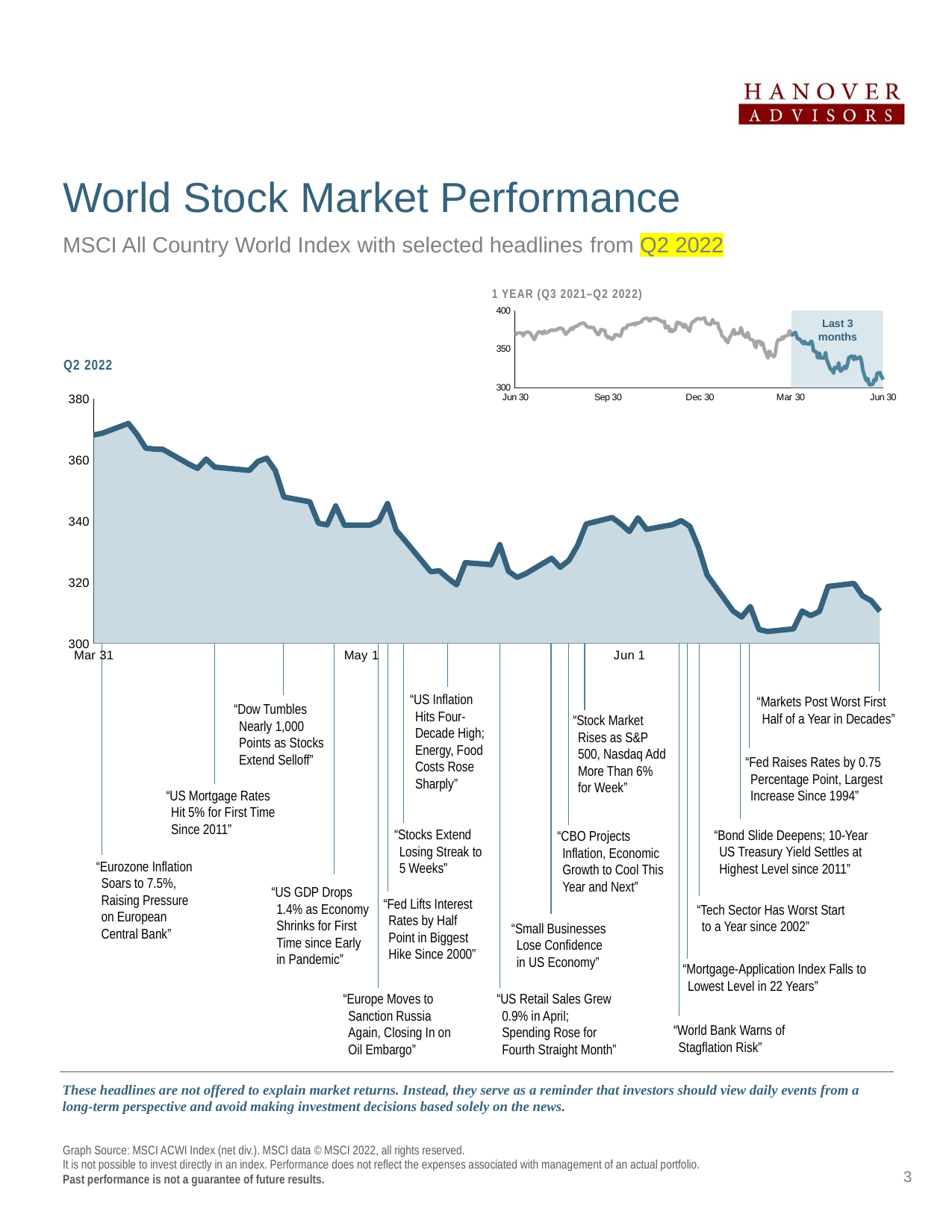
In the 1 YEAR (Q3 2021–Q2 2022) inset chart, do the index values rise or fall overall from Jun 30 2021 to Jun 30 2022? fall In the Q2 2022 chart, do the index values generally rise or fall from Mar 31 to the end of June? fall How many date labels are shown on the x axis of the Q2 2022 chart? 3 What kind of chart is the Q2 2022 chart on the slide? area chart In the 1 YEAR (Q3 2021–Q2 2022) inset chart, is the index value at the final Jun 30 greater or less than 350? less What is the highest value shown on the y axis of the Q2 2022 chart? 380 What label is printed on the shaded region of the 1 YEAR (Q3 2021–Q2 2022) inset chart? Last 3 months In the 1 YEAR (Q3 2021–Q2 2022) inset chart, is the index value at Dec 30 greater or less than 350? greater In the Q2 2022 chart, is the index value at the end of the period (Jun 30) greater or less than 320? less In the Q2 2022 chart, is the index value at Mar 31 higher or lower than the value at the end of June? higher How many date labels are shown on the x axis of the 1 YEAR (Q3 2021–Q2 2022) inset chart? 5